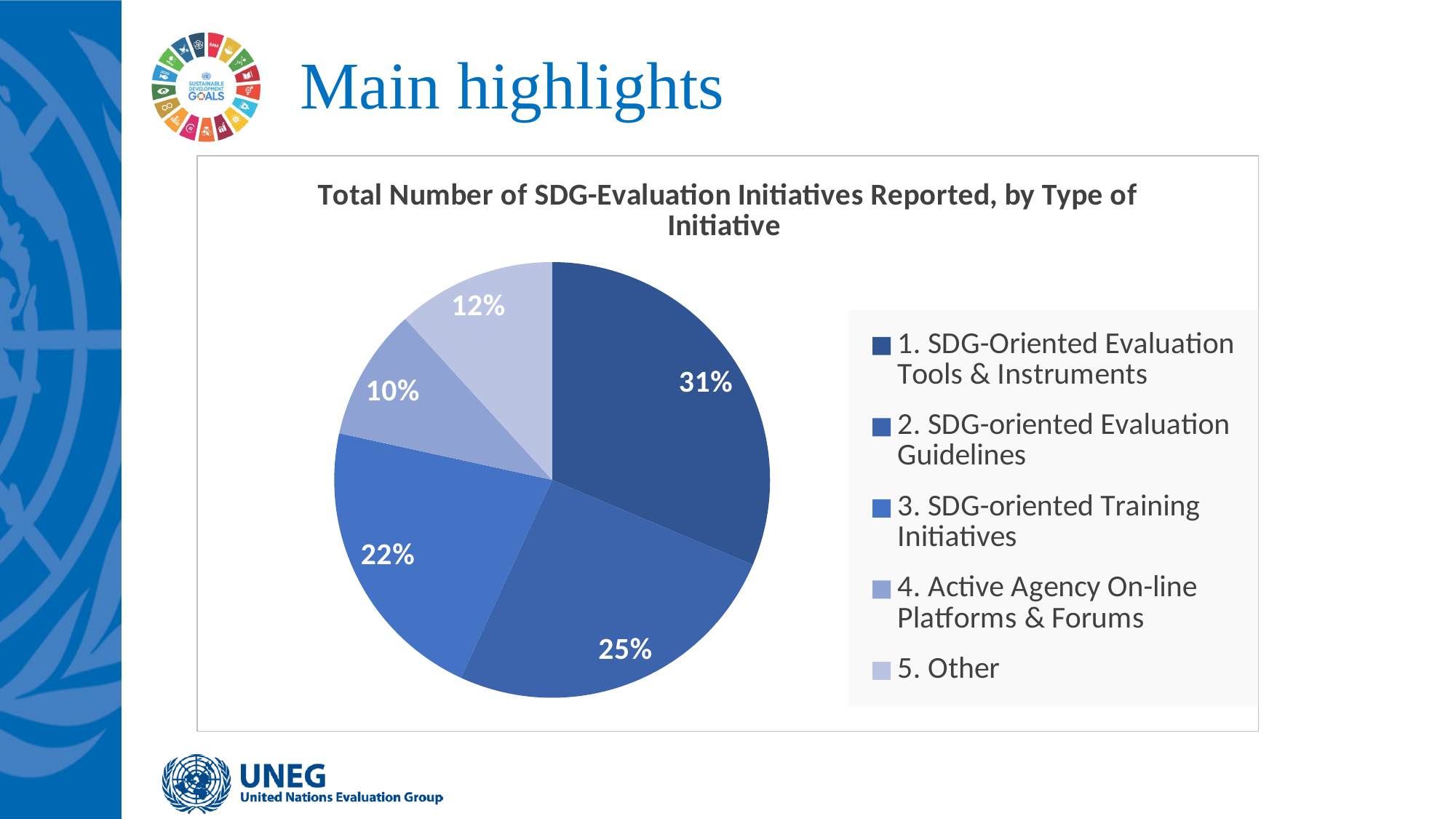
What is the difference in percentage points between '1. SDG-Oriented Evaluation Tools & Instruments' and '3. SDG-oriented Training Initiatives'? 9 percentage points Which type of initiative has the smallest share? 4. Active Agency On-line Platforms & Forums What type of chart is shown on the slide? Pie chart Which type of initiative has the largest share? 1. SDG-Oriented Evaluation Tools & Instruments What share of the pie is '2. SDG-oriented Evaluation Guidelines'? 25% Which has a larger share: '5. Other' or '4. Active Agency On-line Platforms & Forums'? 5. Other What share of the pie is '4. Active Agency On-line Platforms & Forums'? 10% What is the title of the chart? Total Number of SDG-Evaluation Initiatives Reported, by Type of Initiative How many slices does the pie chart have? 5 What share of the pie is '1. SDG-Oriented Evaluation Tools & Instruments'? 31%